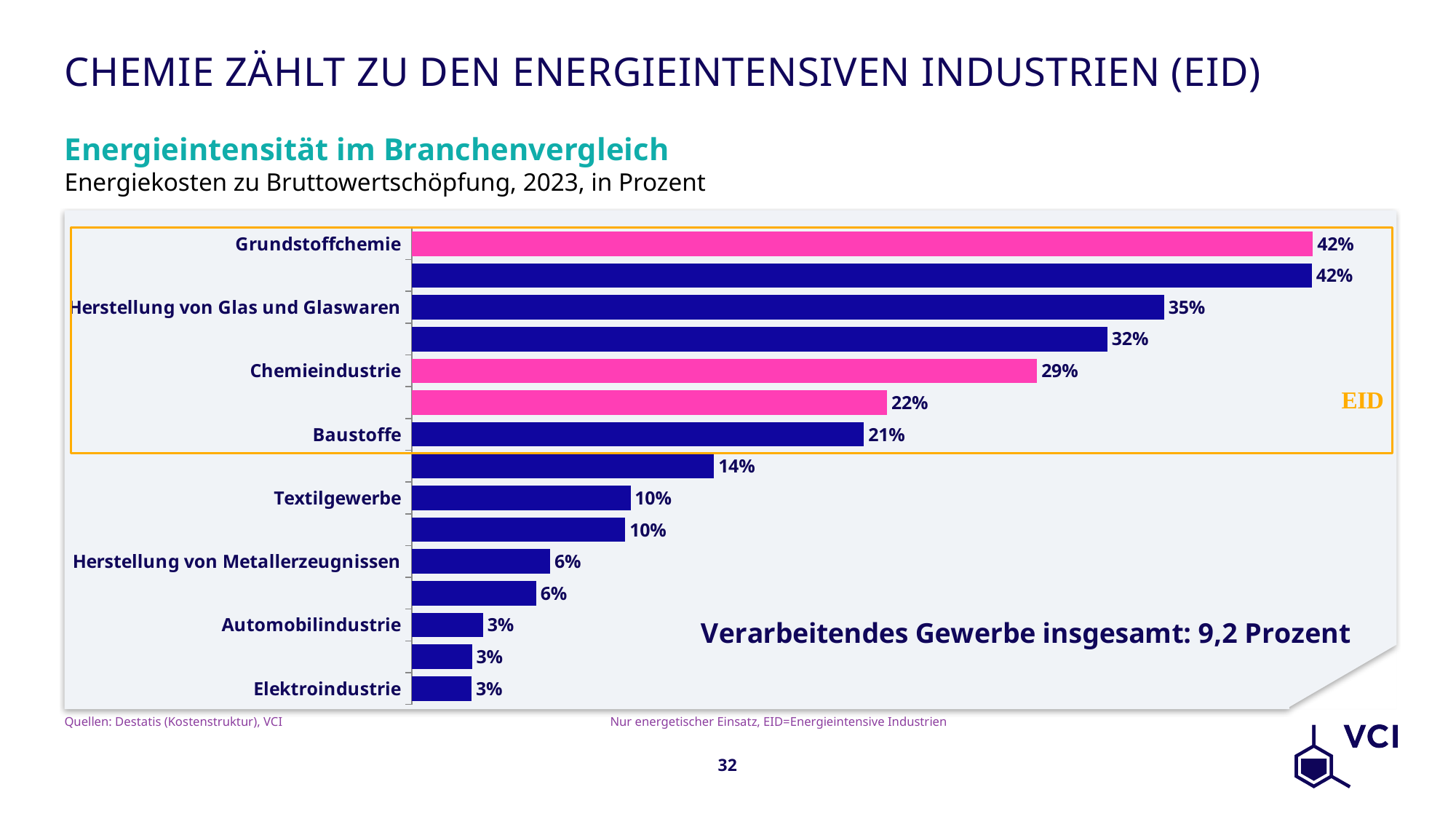
How many bars are plotted in the chart? 15 What is the value for Grundstoffchemie? 42% What is the value for Herstellung von Glas und Glaswaren? 35% What is the value for Elektroindustrie? 3% What is the difference between the values for Textilgewerbe and Automobilindustrie? 7% Which is larger, the value for Chemieindustrie or the value for Baustoffe? Chemieindustrie What value does the chart give for Verarbeitendes Gewerbe insgesamt? 9,2 Prozent What is the value for Textilgewerbe? 10% What kind of chart is shown on the slide? bar chart What is the difference between the values for Grundstoffchemie and Chemieindustrie? 13% What is the value for Baustoffe? 21% What is the value for Chemieindustrie? 29%